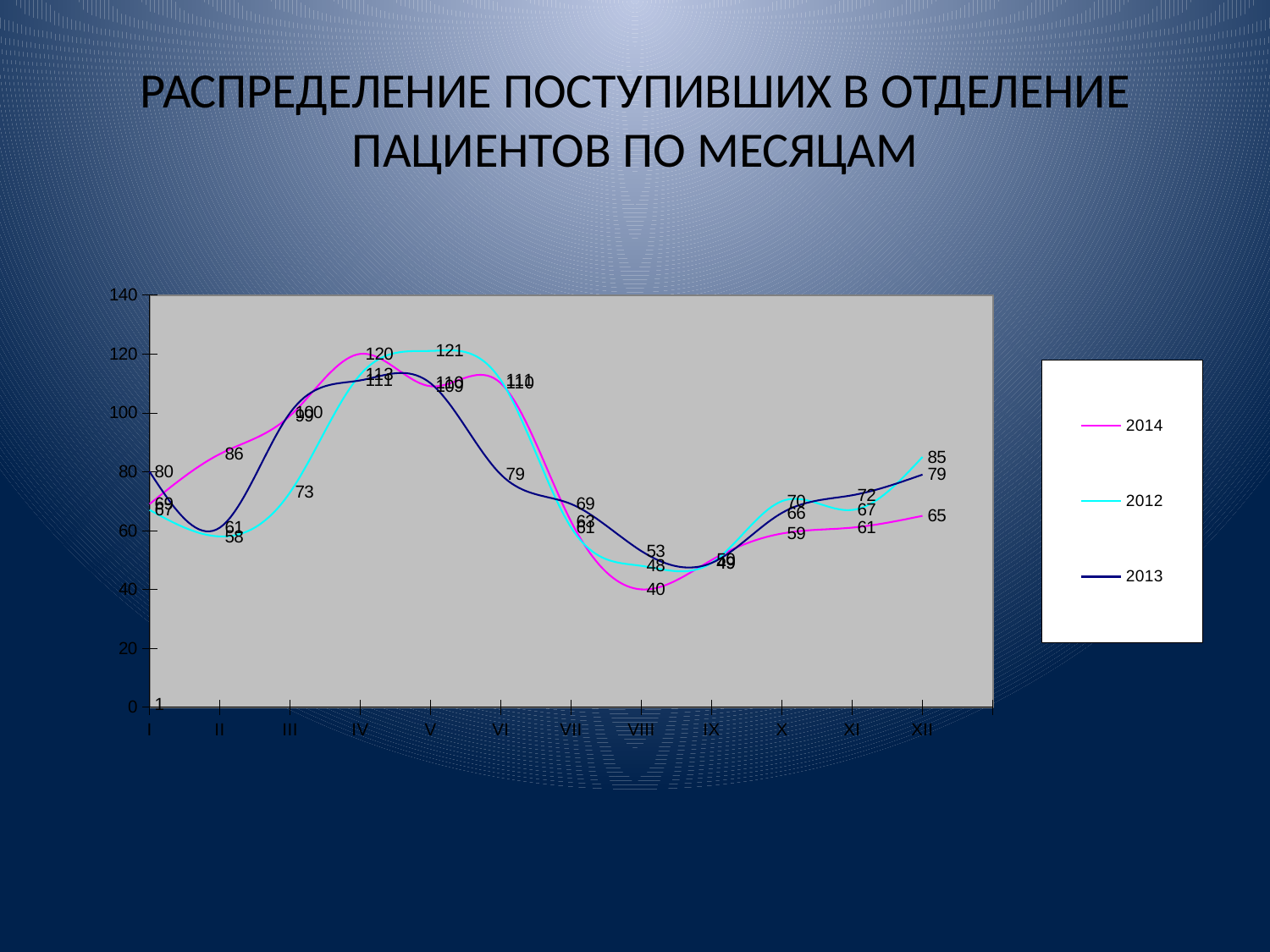
Which years are listed in the legend? 2014, 2012, 2013 In which month is the 2014 series at its lowest? VIII In month XII, which series has the larger value, 2012 or 2013? 2012 In which month is the 2012 series at its highest? V What is the value for 2014 in month VIII? 40 What kind of chart is shown on the slide? line chart How many months (categories) are plotted along the x axis? 12 What is the value for 2012 in month V? 121 What is the difference between the 2012 and 2014 values in month XII? 20 How many series does the legend list? 3 What is the value for 2014 in month IV? 120 What is the value for 2013 in month VI? 79